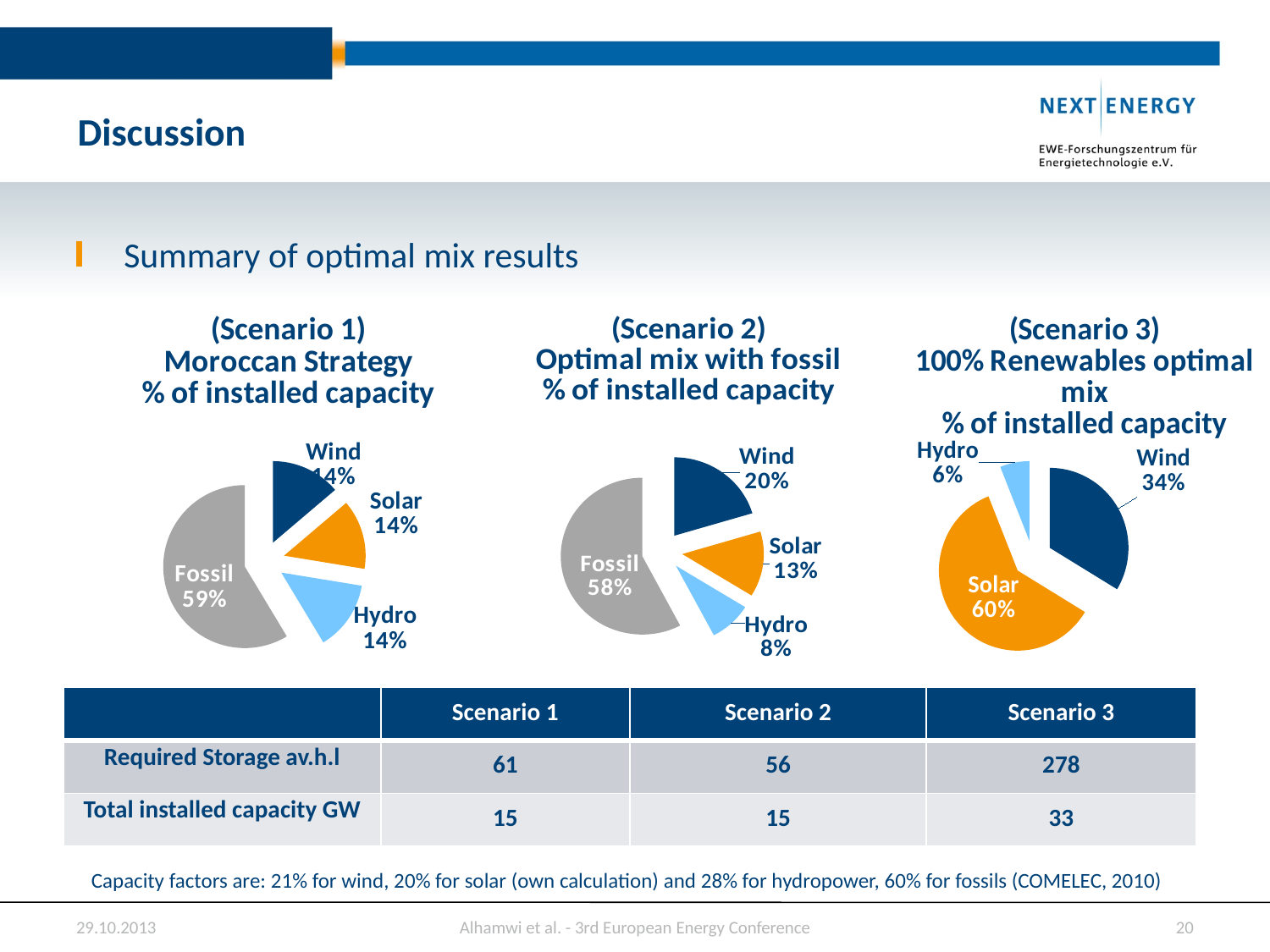
In the Scenario 1 (Moroccan Strategy) pie chart, what share of installed capacity is Fossil? 59% In the Scenario 1 (Moroccan Strategy) pie chart, which source has the largest share? Fossil In the Scenario 3 (100% Renewables optimal mix) pie chart, which source has the largest share? Solar How many slices does the Scenario 3 (100% Renewables optimal mix) pie chart have? 3 In the Scenario 2 (Optimal mix with fossil) pie chart, which source has the smallest share? Hydro In the Scenario 3 (100% Renewables optimal mix) pie chart, how many percentage points larger is the Solar share than the Wind share? 26 percentage points In the Scenario 3 (100% Renewables optimal mix) pie chart, what share of installed capacity is Hydro? 6% In the Scenario 3 (100% Renewables optimal mix) pie chart, what share of installed capacity is Solar? 60% In the Scenario 2 (Optimal mix with fossil) pie chart, which is larger, the Solar share or the Hydro share? Solar In the Scenario 2 (Optimal mix with fossil) pie chart, how many percentage points larger is the Fossil share than the Wind share? 38 percentage points In the Scenario 2 (Optimal mix with fossil) pie chart, what share of installed capacity is Wind? 20% In the Scenario 1 (Moroccan Strategy) pie chart, what share of installed capacity is Hydro? 14%